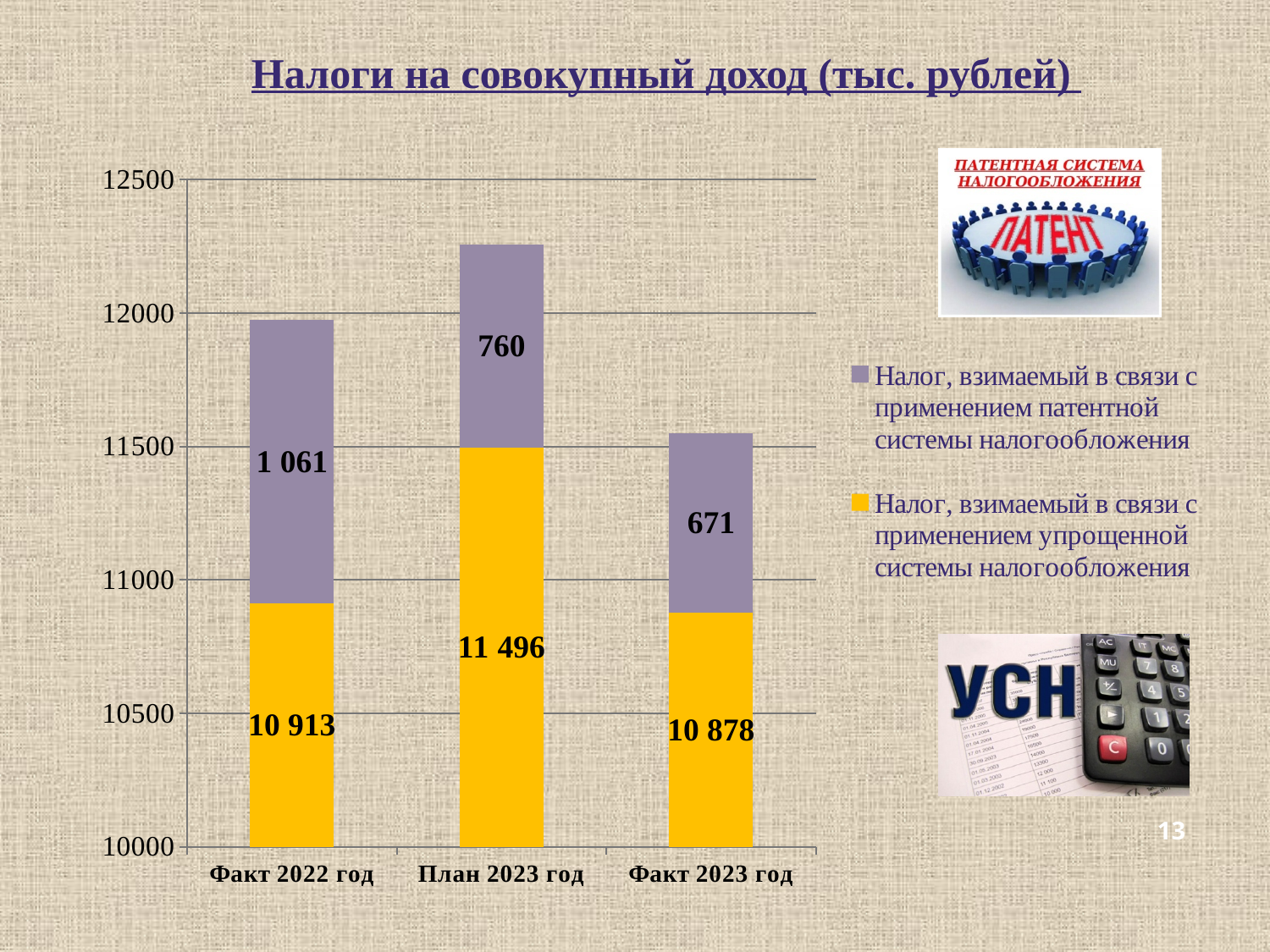
How many series does the legend list? 2 Which is larger: the patent taxation system tax for Факт 2022 год or for План 2023 год? Факт 2022 год What is the value of the simplified taxation system tax (yellow series) for Факт 2022 год? 10 913 How many categories are shown on the x axis? 3 What is the value of the patent taxation system tax (purple series) for План 2023 год? 760 What kind of chart is shown on the slide? Stacked bar chart What is the value of the patent taxation system tax for Факт 2023 год? 671 What is the total of the stacked bar for Факт 2022 год? 11 974 Which category has the lowest value for the patent taxation system tax (purple series)? Факт 2023 год What is the total of the stacked bar for Факт 2023 год? 11 549 What is the difference between the simplified taxation system tax for План 2023 год and Факт 2023 год? 618 Which category has the highest value for the simplified taxation system tax (yellow series)? План 2023 год